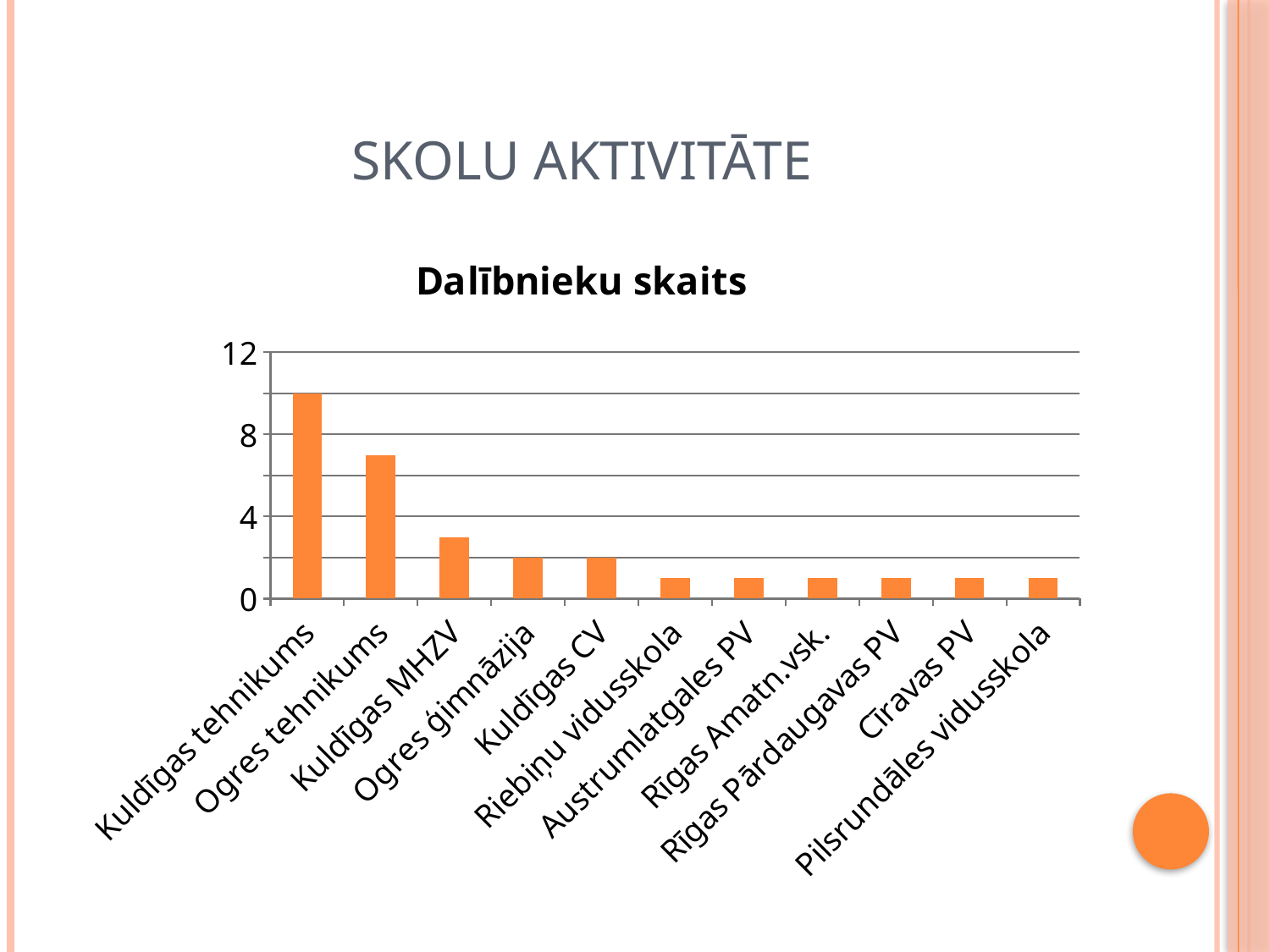
Do the values generally rise or fall from left to right along the x axis? fall Is the value for Kuldīgas MHZV greater or less than 4? less Which is larger, the value for Ogres tehnikums or the value for Kuldīgas MHZV? Ogres tehnikums What is the title of the chart? Dalībnieku skaits What type of chart is shown on the slide? bar chart Which is larger, the value for Kuldīgas tehnikums or the value for Ogres tehnikums? Kuldīgas tehnikums Is the value for Riebiņu vidusskola greater or less than 4? less How many schools (categories) are shown on the x axis of the chart? 11 Is the value for Ogres tehnikums greater or less than 4? greater Which school has the highest value in the chart? Kuldīgas tehnikums